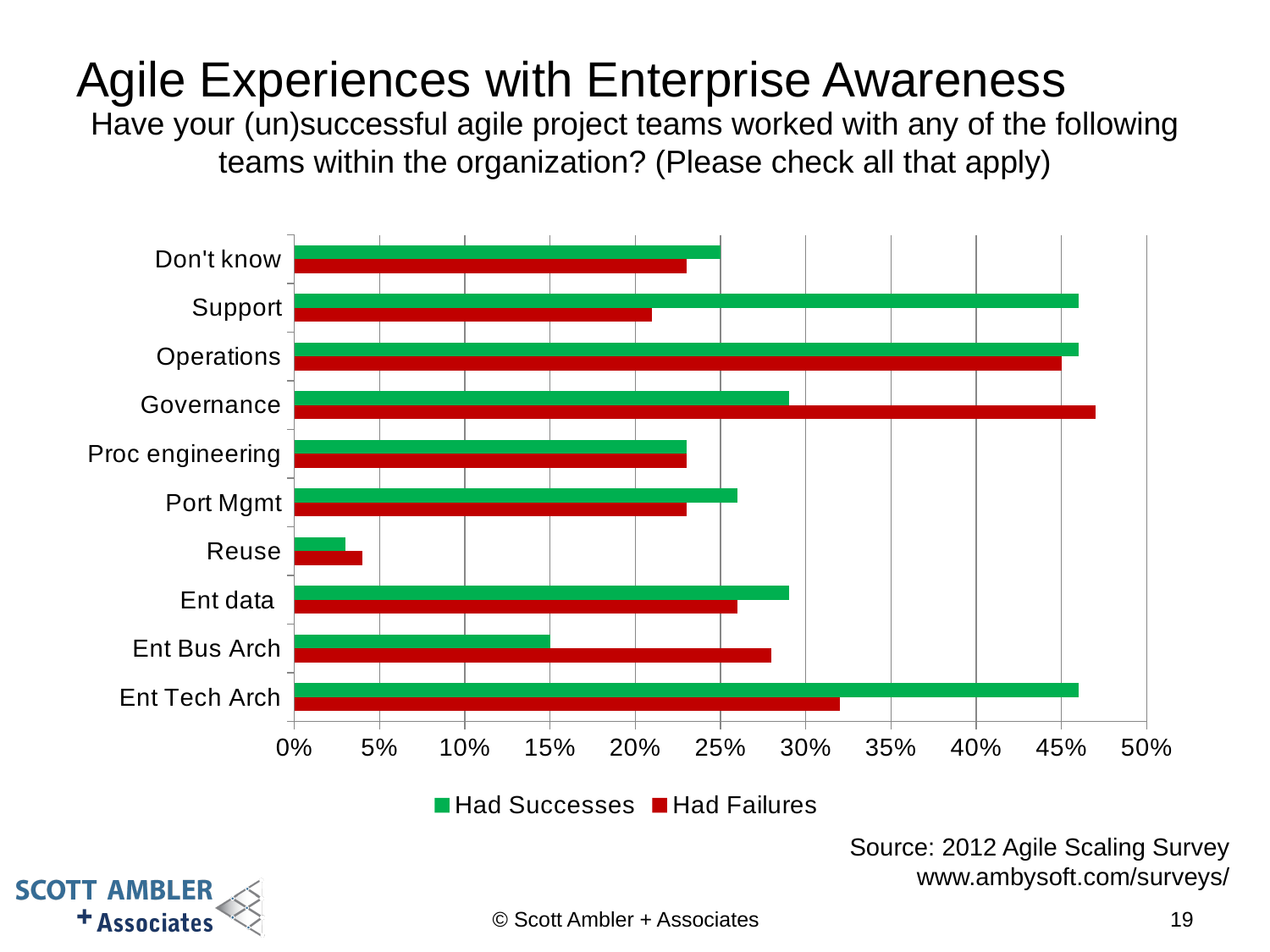
Which colour represents the Had Failures series? red Is the Had Failures value for Governance greater or less than 40%? greater Which category has the lowest Had Successes value? Reuse For Support, which series has the larger value, Had Successes or Had Failures? Had Successes Is the Had Failures value for Support greater or less than 25%? less How many series does the legend list? 2 What kind of chart is shown on the slide? bar chart For Governance, which series has the larger value, Had Successes or Had Failures? Had Failures How many categories are shown on the chart? 10 Is the Had Successes value for Ent Tech Arch greater or less than 40%? greater Which category has the lowest Had Failures value? Reuse